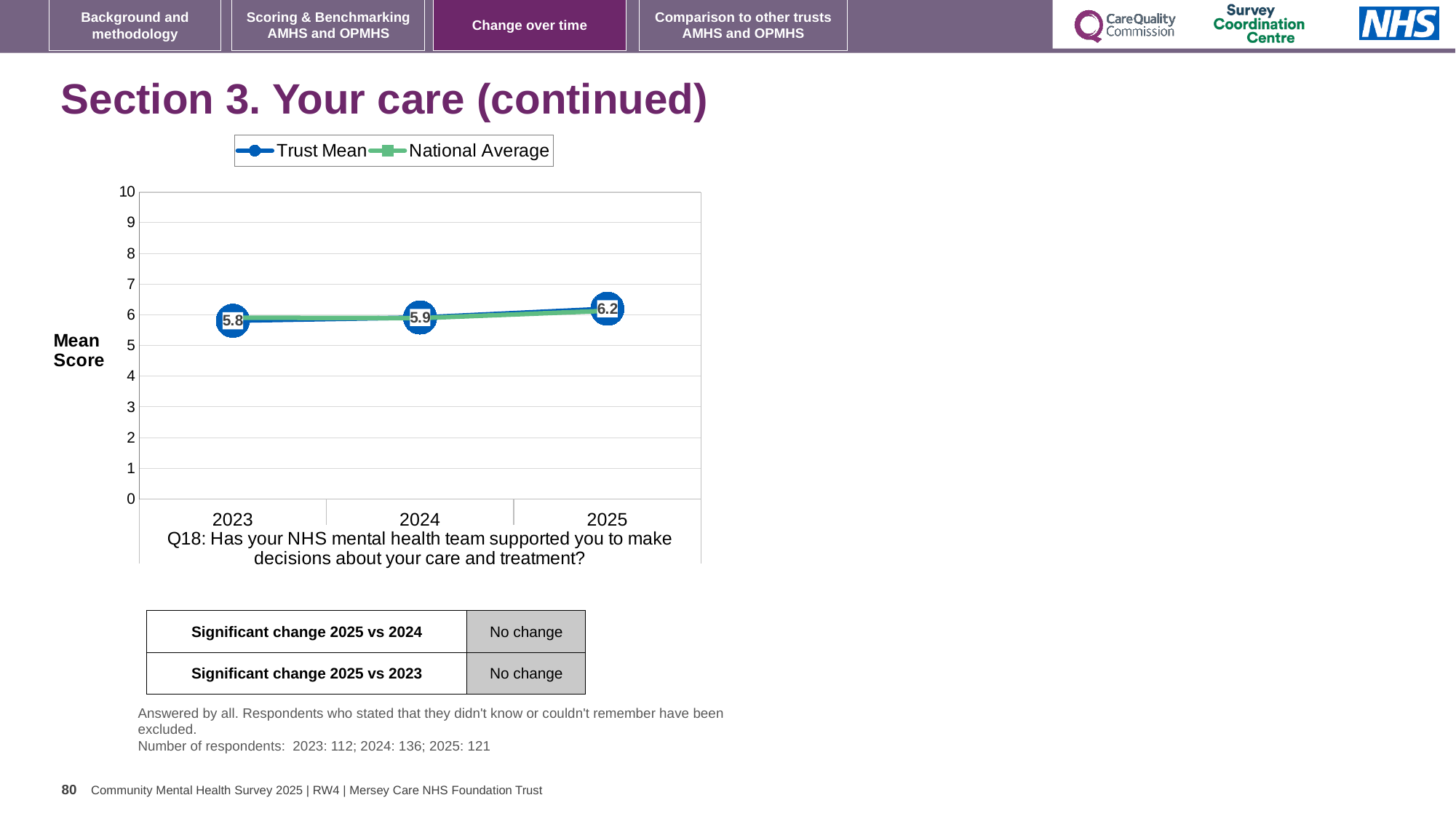
What kind of chart is shown on the slide? line chart In which year is the Trust Mean lowest? 2023 How many years are shown on the x axis of the chart? 3 Which is larger, the Trust Mean for 2025 or for 2023? 2025 In which year is the Trust Mean highest? 2025 What is the Trust Mean value for 2025? 6.2 What is the Trust Mean value for 2023? 5.8 What is the difference between the Trust Mean in 2025 and in 2024? 0.3 What is the Trust Mean value for 2024? 5.9 Is the Trust Mean value for 2025 greater or less than 5? greater How many series does the chart legend list? 2 What is the difference between the Trust Mean in 2025 and in 2023? 0.4